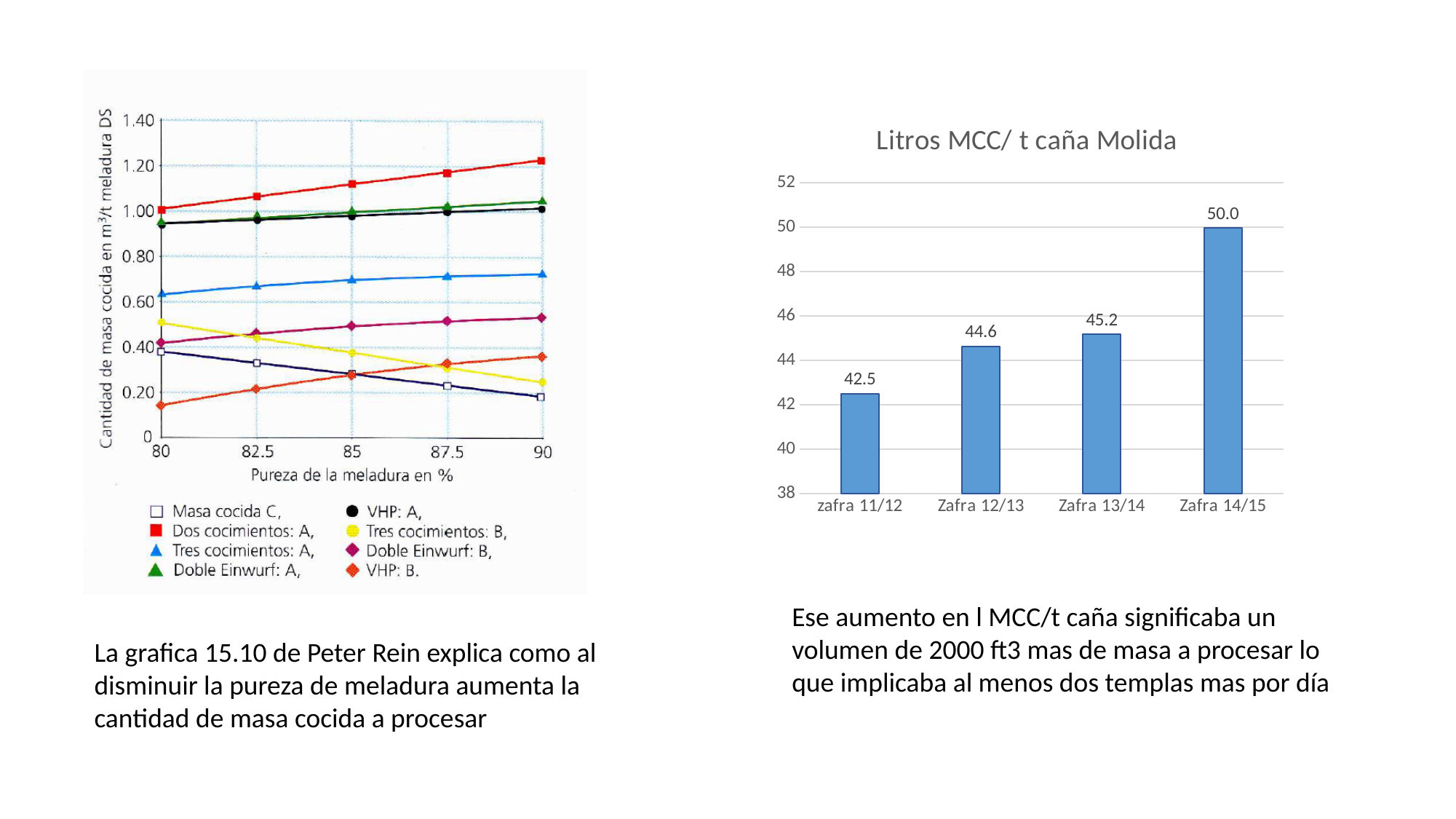
In the chart titled 'Litros MCC/ t caña Molida', what is the value for Zafra 14/15? 50.0 In the chart titled 'Litros MCC/ t caña Molida', how many bars are plotted? 4 In the line chart on the left, how many series does the legend list? 8 In the line chart on the left, does the 'Masa cocida C' line rise or fall as purity increases from 80 to 90? fall In the line chart on the left, is the value for 'Tres cocimientos: A' at 80% purity greater or less than 0.60? greater In the chart titled 'Litros MCC/ t caña Molida', what is the difference between Zafra 14/15 and Zafra 13/14? 4.8 In the chart titled 'Litros MCC/ t caña Molida', which is larger, Zafra 12/13 or Zafra 13/14? Zafra 13/14 In the chart titled 'Litros MCC/ t caña Molida', which zafra has the highest value? Zafra 14/15 In the chart titled 'Litros MCC/ t caña Molida', what is the value for zafra 11/12? 42.5 What kind of chart is the one on the right side of the slide? bar chart In the chart titled 'Litros MCC/ t caña Molida', do the values rise or fall from zafra 11/12 to Zafra 14/15? rise In the chart titled 'Litros MCC/ t caña Molida', which zafra has the lowest value? zafra 11/12